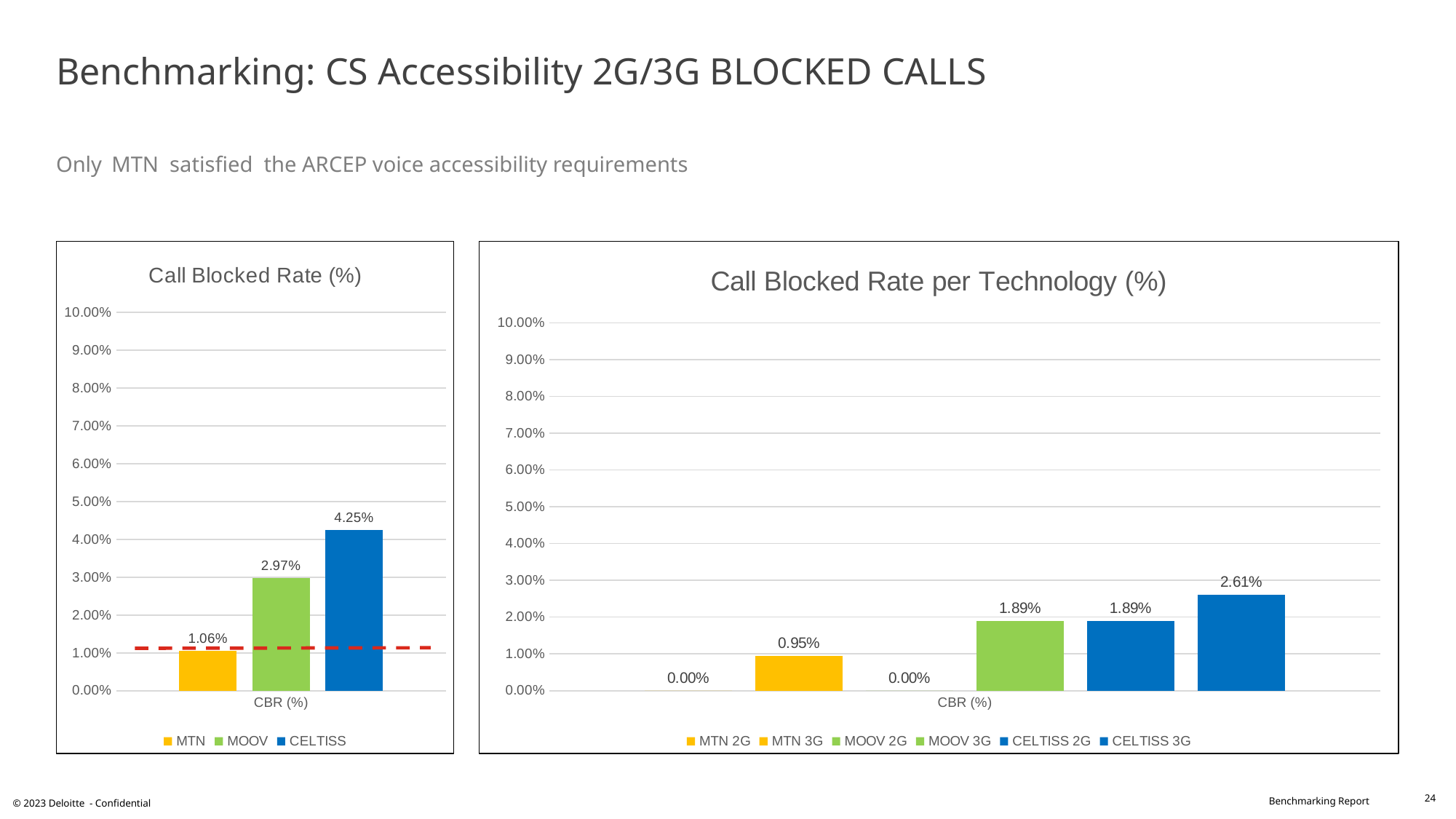
In the 'Call Blocked Rate (%)' chart, which operator has the lowest call blocked rate? MTN In the 'Call Blocked Rate per Technology (%)' chart, what is the value for MTN 3G? 0.95% In the 'Call Blocked Rate per Technology (%)' chart, what is the value for CELTISS 3G? 2.61% In the 'Call Blocked Rate per Technology (%)' chart, which is larger, MTN 3G or MOOV 3G? MOOV 3G In the 'Call Blocked Rate (%)' chart, how many series does the legend list? 3 In the 'Call Blocked Rate per Technology (%)' chart, what is the difference between CELTISS 3G and MOOV 3G? 0.72% In the 'Call Blocked Rate per Technology (%)' chart, how many series does the legend list? 6 In the 'Call Blocked Rate per Technology (%)' chart, which series has the highest value? CELTISS 3G In the 'Call Blocked Rate (%)' chart, what is the value for CELTISS? 4.25% In the 'Call Blocked Rate (%)' chart, what is the value for MOOV? 2.97% In the 'Call Blocked Rate (%)' chart, what is the difference between the CELTISS and MTN values? 3.19% What type of chart is the 'Call Blocked Rate per Technology (%)' chart? Bar chart